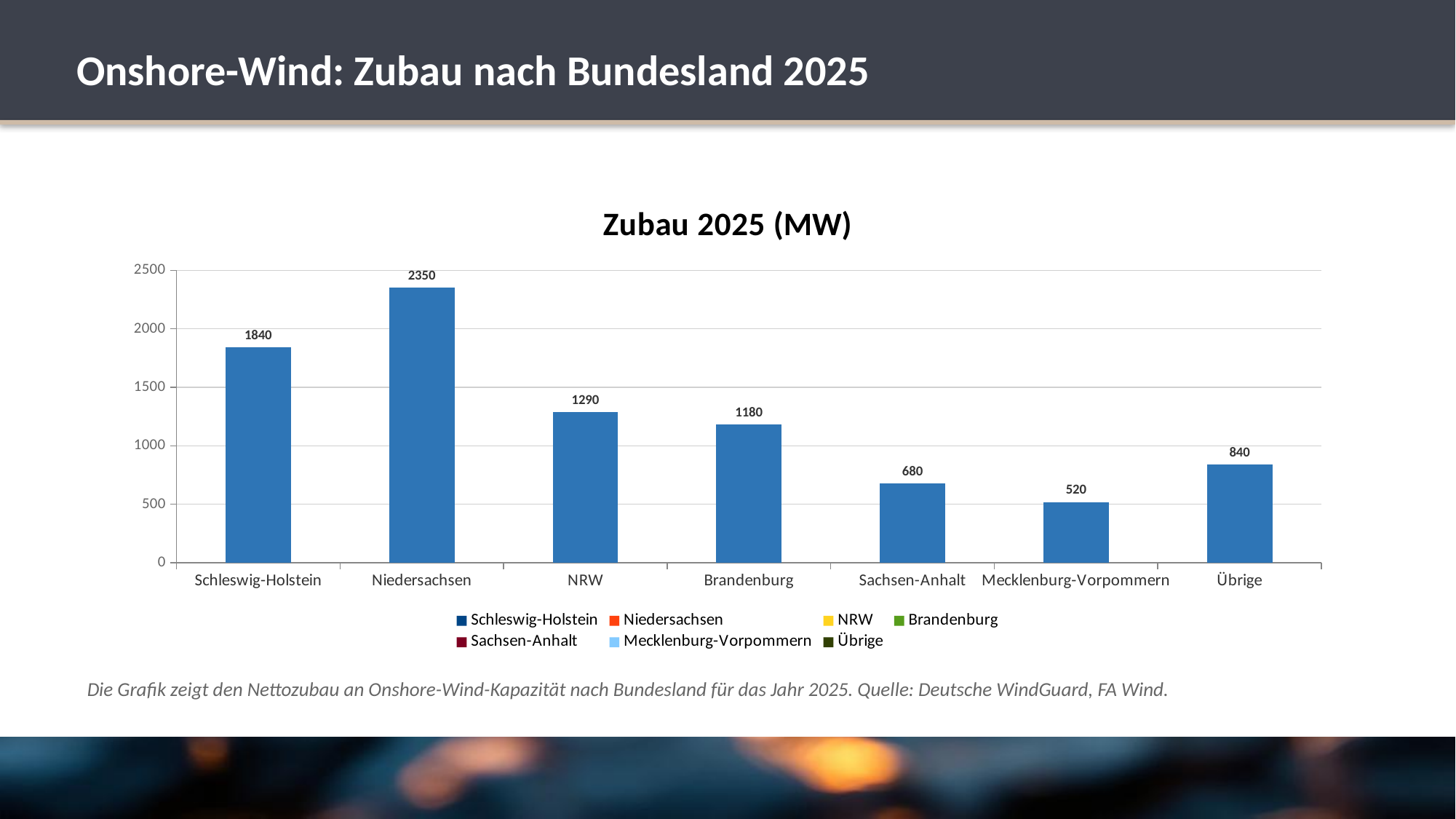
What is the value for Mecklenburg-Vorpommern? 520 Which Bundesland has the highest Zubau 2025? Niedersachsen Is the value for Übrige greater or less than 1000? less What is the value for Niedersachsen? 2350 What is the title of the chart? Zubau 2025 (MW) How many categories are shown on the x axis? 7 What is the value for Übrige? 840 Which is larger, the value for NRW or the value for Brandenburg? NRW What is the difference between Brandenburg and Sachsen-Anhalt? 500 What kind of chart is shown? bar chart Which category has the lowest value? Mecklenburg-Vorpommern What is the difference between Schleswig-Holstein and NRW? 550